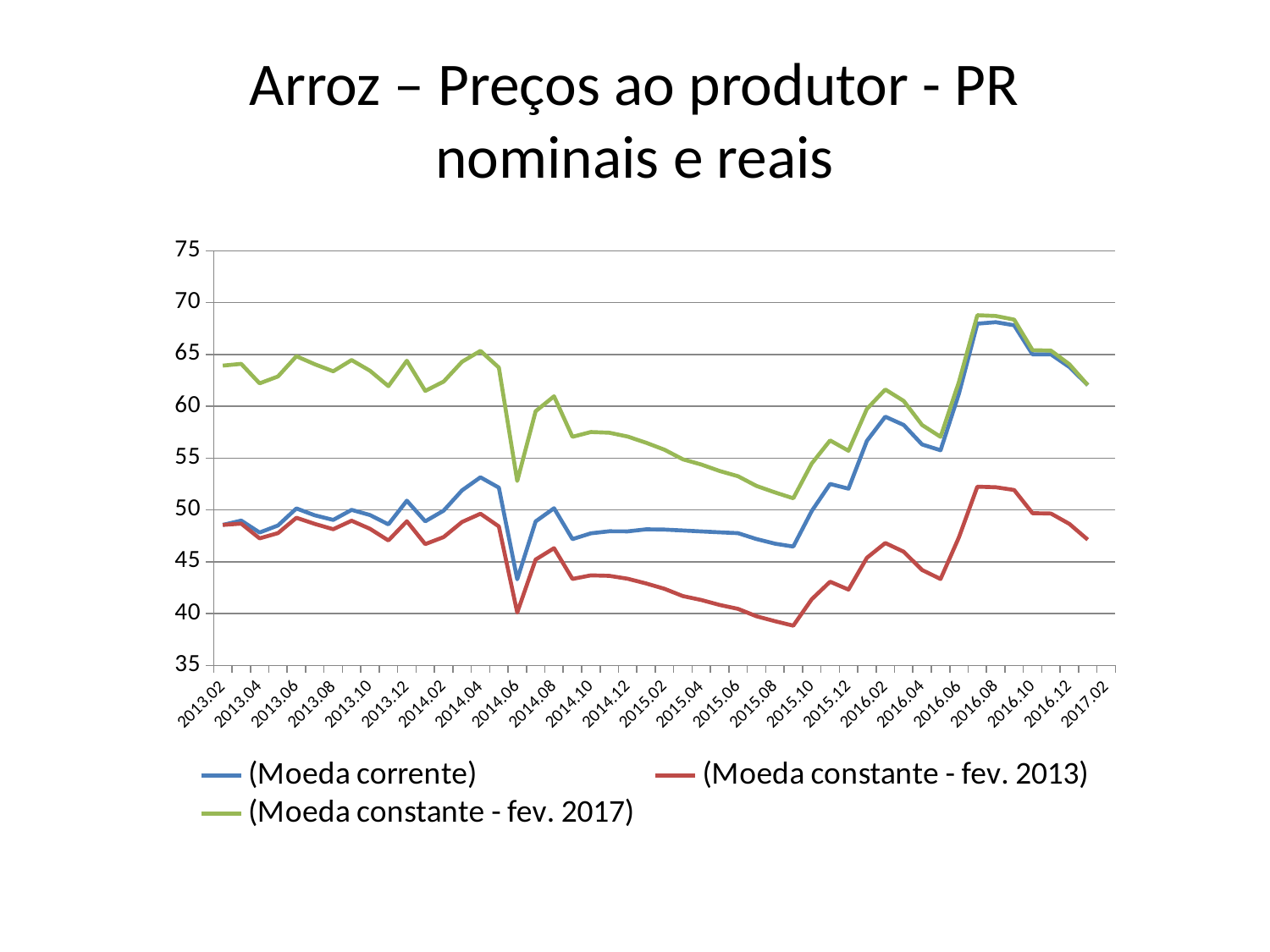
Is the value of (Moeda constante - fev. 2013) at 2015.08 greater or less than 40? less What is the title of the chart? Arroz – Preços ao produtor - PR nominais e reais Is the value of (Moeda constante - fev. 2017) at 2016.08 greater or less than 65? greater How many series does the legend list? 3 Is the value of (Moeda corrente) at 2014.06 greater or less than 45? less Does the (Moeda constante - fev. 2013) line rise or fall between 2014.10 and 2015.08? fall What kind of chart is shown on the slide? line chart Which series is plotted highest across the whole period? (Moeda constante - fev. 2017) Which series is plotted lowest across the whole period? (Moeda constante - fev. 2013)